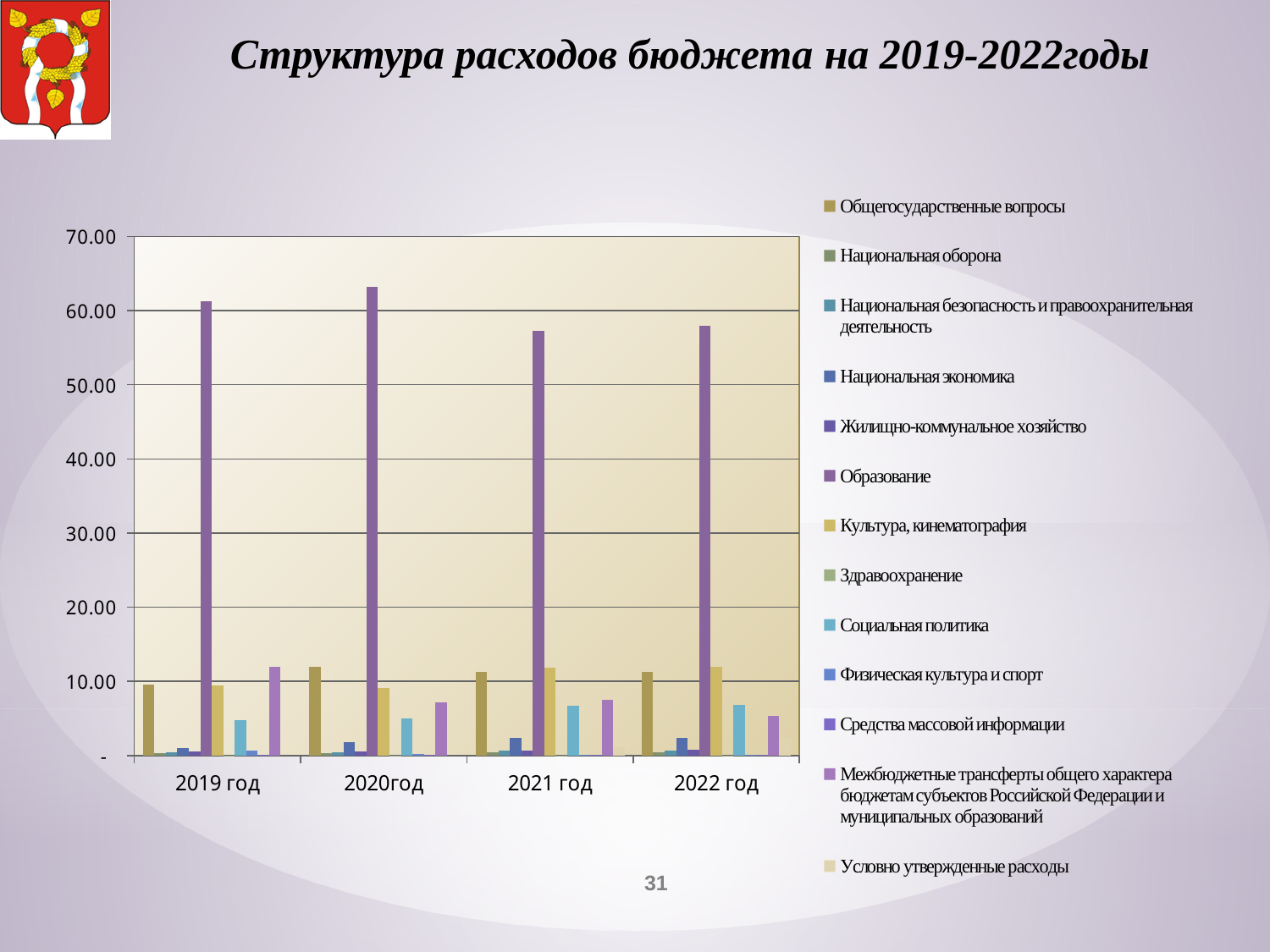
Is the value for Межбюджетные трансферты общего характера бюджетам субъектов Российской Федерации и муниципальных образований in 2022 год greater or less than 10.00? less How many series does the chart legend list? 13 What is the title of the slide's chart? Структура расходов бюджета на 2019-2022годы Is the value for Образование in 2021 год greater or less than 60.00? less Is the value for Образование in 2019 год greater or less than 60.00? greater Which series has the tallest bar in every year group? Образование Which is larger: the value for Образование in 2020год or in 2021 год? 2020год In which year is the value for Образование the highest? 2020год What is the first entry listed in the chart legend? Общегосударственные вопросы How many year categories are shown on the x axis of the chart? 4 What kind of chart is shown on the slide? bar chart